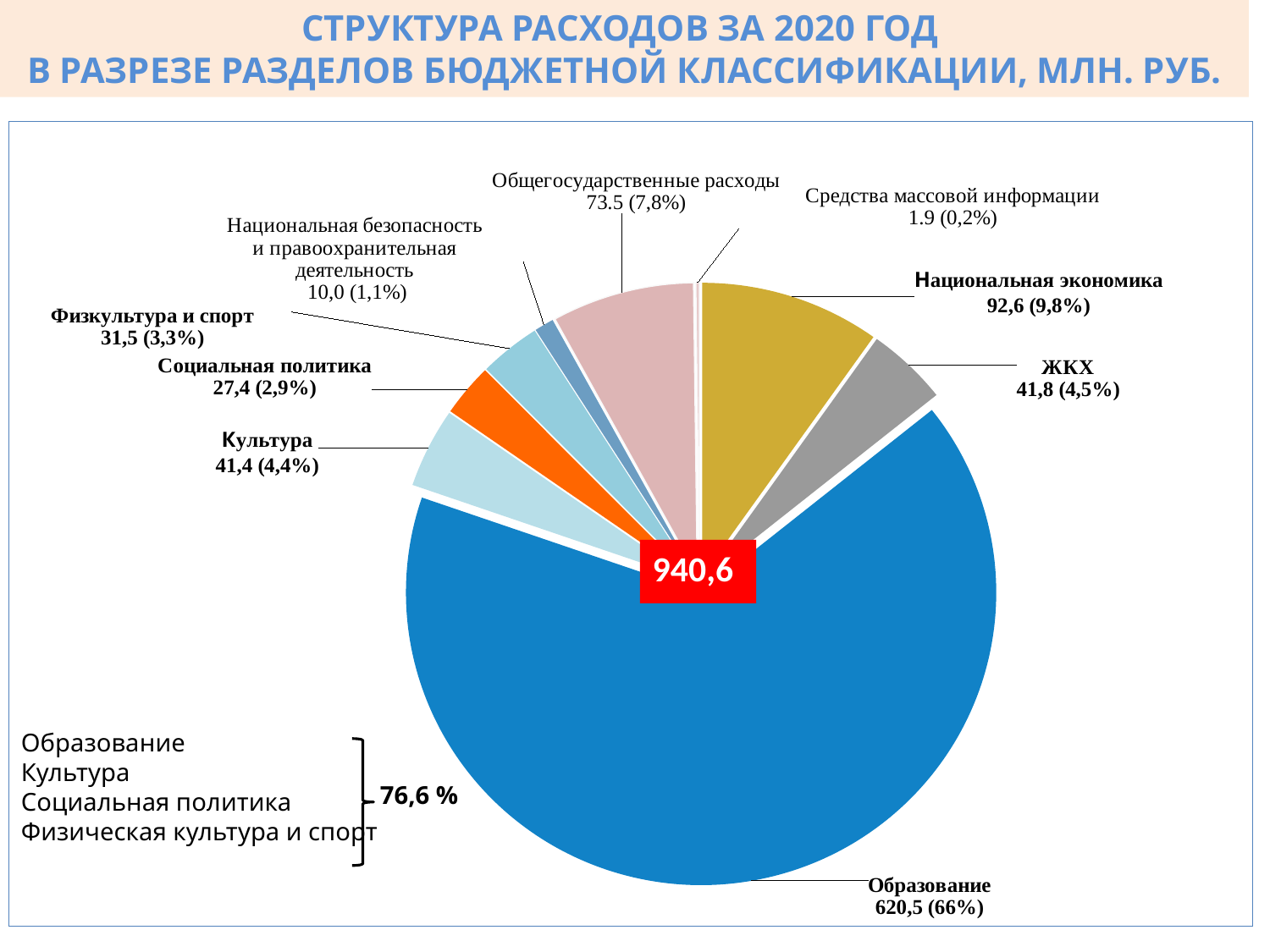
What is the value for Образование? 620,5 Which category has the largest slice of the pie? Образование What is the value for Общегосударственные расходы? 73.5 What kind of chart is shown on the slide? pie chart How many slices does the pie chart have? 9 Which category has the smallest slice of the pie? Средства массовой информации What share of the pie does ЖКХ account for? 4,5% What is the difference between the values for Национальная экономика and ЖКХ? 50,8 What is the value for Национальная экономика? 92,6 What is the value for Средства массовой информации? 1.9 Which is larger, the value for Физкультура и спорт or the value for Социальная политика? Физкультура и спорт What share of the pie does Образование account for? 66%